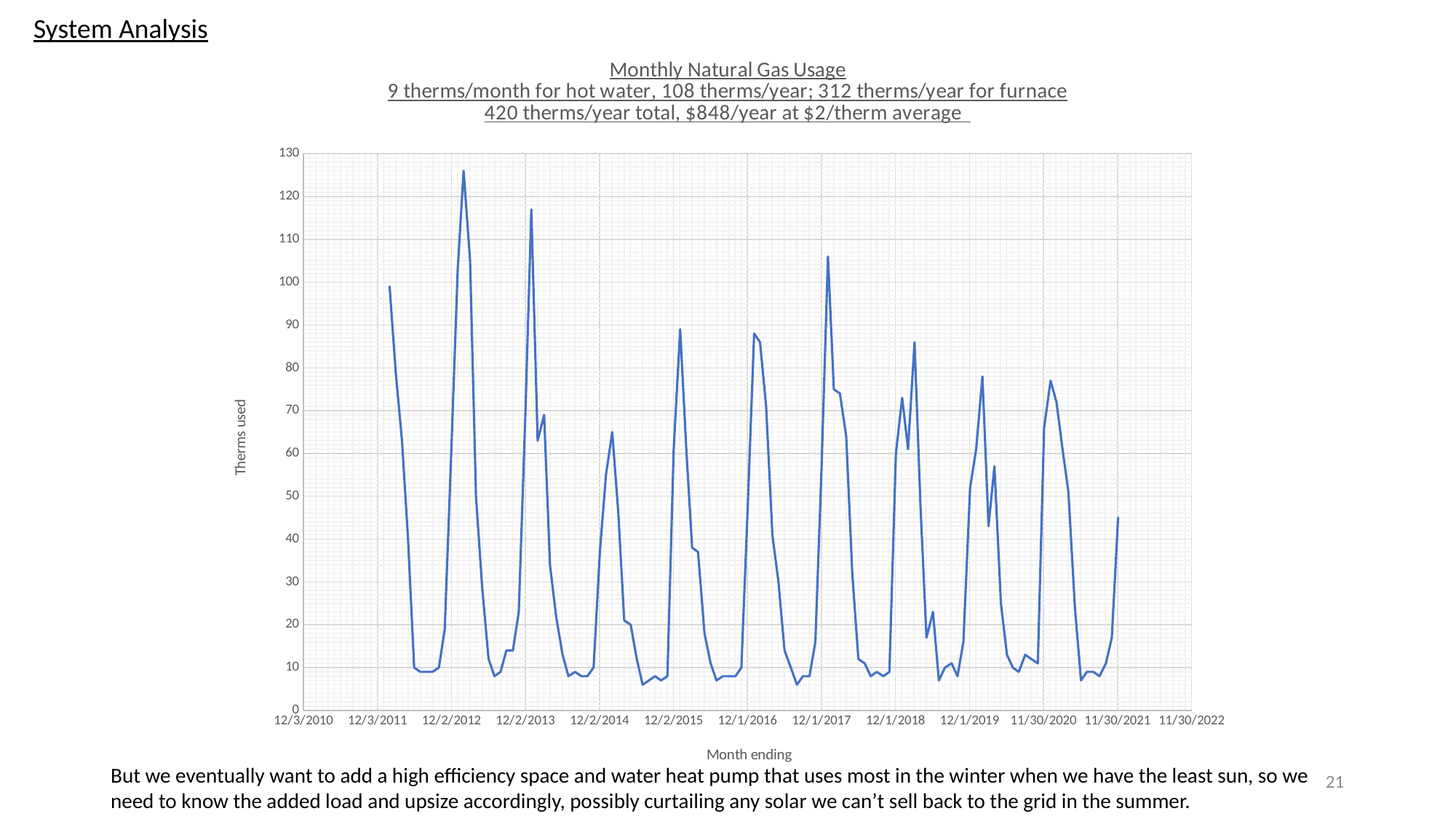
Which is higher: the peak just after the 12/2/2014 tick or the peak just after the 12/2/2015 tick? the peak after 12/2/2015 Which is higher: the peak just after the 12/2/2012 tick or the peak just after the 12/2/2013 tick? the peak after 12/2/2012 Is the peak just after the 12/2/2013 tick greater or less than 110 therms? greater According to the chart title, what is the total natural gas usage per year? 420 therms/year Are the summer low points of the line (for example in mid-2016) greater or less than 10 therms? less What kind of chart is shown on the slide? line chart Is the highest peak of the line, just after the 12/2/2012 tick, greater or less than 120 therms? greater What is the label of the y axis? Therms used Near which x-axis tick does the highest peak of the whole series occur? 12/2/2012